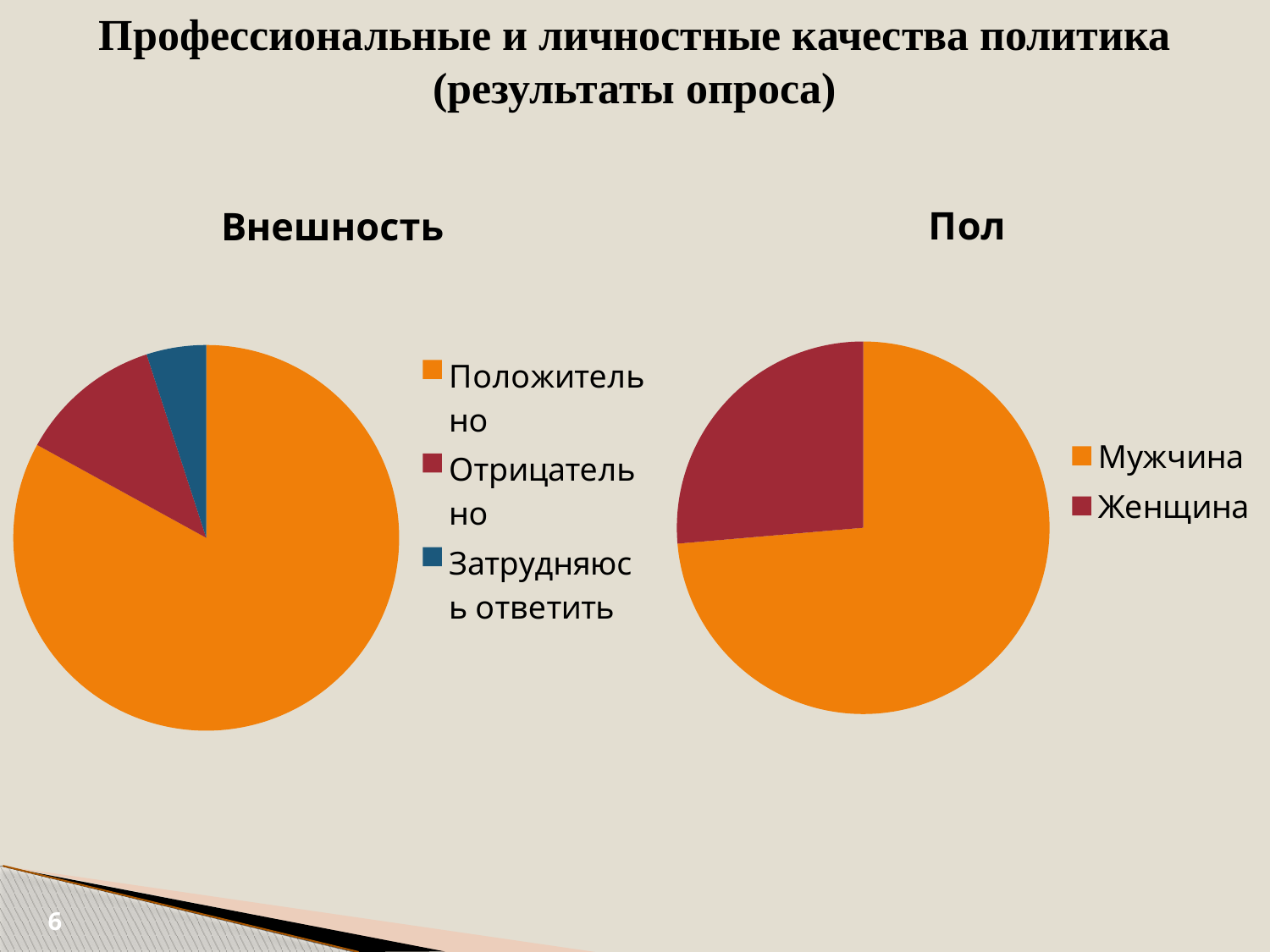
In the "Внешность" chart, which category has the largest slice? Положительно In the "Внешность" chart, which category has the smallest slice? Затрудняюсь ответить In the "Пол" chart, how many slices does the pie have? 2 What kind of chart is the "Пол" chart? Pie chart In the "Пол" chart, which category has the smallest slice? Женщина In the "Внешность" chart, which slice is larger: Отрицательно or Затрудняюсь ответить? Отрицательно In the "Пол" chart, which category has the largest slice? Мужчина In the "Внешность" chart, how many slices does the pie have? 3 In the "Пол" chart, what colour is the Женщина slice? Dark red In the "Внешность" chart, how many entries does the legend list? 3 In the "Пол" chart, which slice is larger: Мужчина or Женщина? Мужчина What kind of chart is the "Внешность" chart? Pie chart